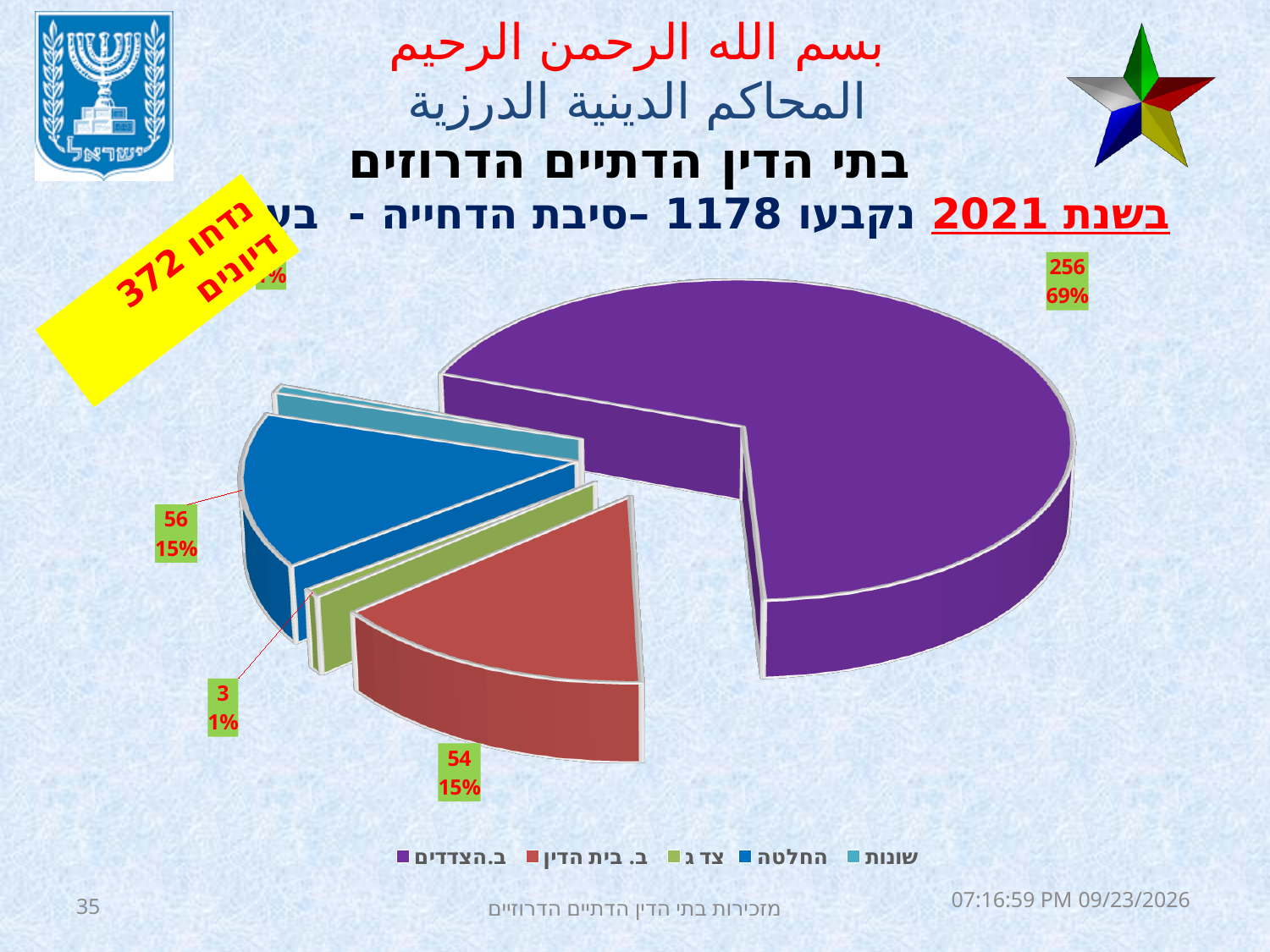
What percentage share is shown for the ב.הצדדים slice? 69% How many entries does the legend of the pie chart list? 5 What kind of chart is shown on the slide? pie chart What value is shown for the ב. בית הדין slice? 54 What is the difference between the ב.הצדדים value and the ב. בית הדין value? 202 What value is shown for the החלטה slice? 56 Which category has the largest slice of the pie? ב.הצדדים What percentage share is shown for the צד ג slice? 1% What colour is the ב.הצדדים slice in the pie chart? purple What value is shown for the צד ג slice? 3 Which is larger, the ב.הצדדים slice or the החלטה slice? ב.הצדדים What value is shown for the ב.הצדדים slice? 256